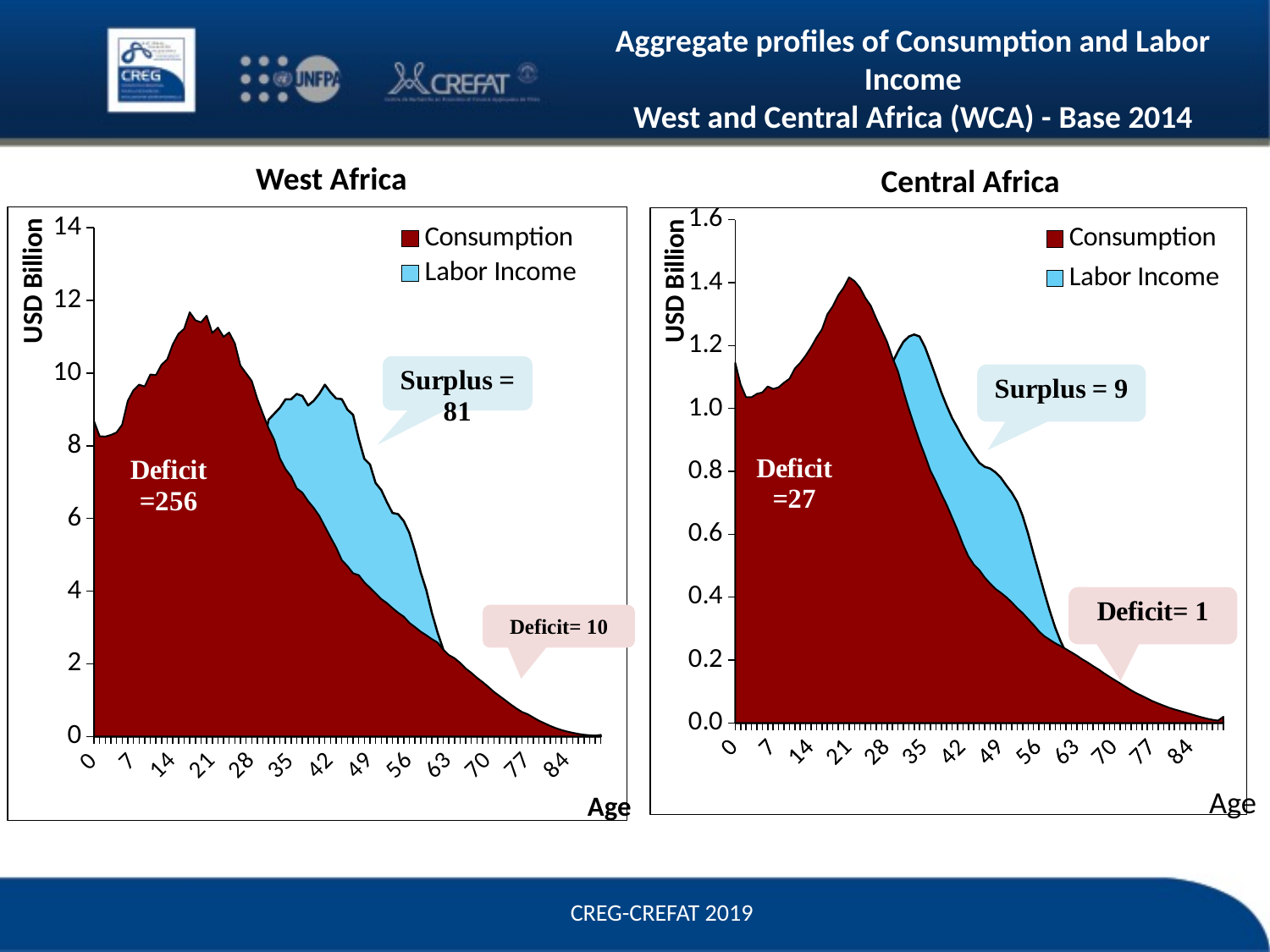
In the Central Africa chart, what is the annotated surplus value? 9 In the Central Africa chart, does consumption rise or fall along the x axis from age 28 to age 84? Fall What kind of chart is the West Africa chart? Area chart How many series does the legend of the Central Africa chart list? 2 In the West Africa chart, what is the annotated surplus value? 81 In the West Africa chart, what is the deficit annotated at old ages? 10 In the Central Africa chart, what is the deficit annotated at old ages? 1 In the West Africa chart, is the consumption value at age 21 greater or less than 10 USD Billion? greater In the Central Africa chart, what is the deficit annotated at young ages? 27 In the West Africa chart, what is the value of the deficit annotated at young ages? 256 In the West Africa chart, what is the difference between the young-age deficit (256) and the surplus (81)? 175 In the Central Africa chart, which is larger: the young-age deficit or the surplus? Young-age deficit